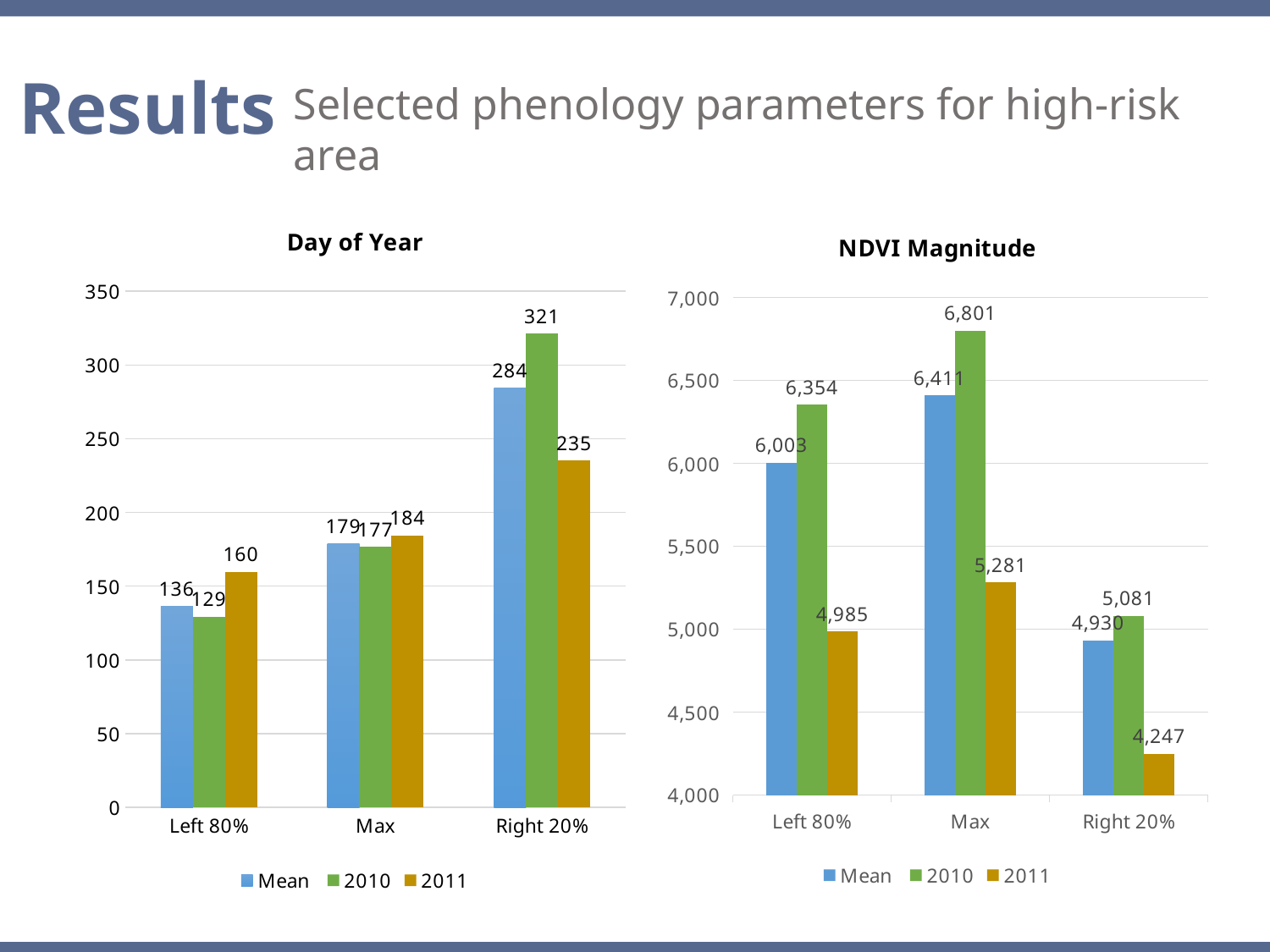
How many categories are shown on the x axis of the Day of Year chart? 3 In the Day of Year chart, what is the difference between the 2010 and 2011 values for Right 20%? 86 In the Day of Year chart, what is the 2010 value for Right 20%? 321 In the NDVI Magnitude chart, what is the difference between the Mean and 2011 values for Left 80%? 1,018 In the Day of Year chart, what is the Mean value for Left 80%? 136 In the NDVI Magnitude chart, which category has the lowest Mean value? Right 20% In the NDVI Magnitude chart, what is the 2011 value for Right 20%? 4,247 In the Day of Year chart, which category has the highest 2011 value? Right 20% How many series does the legend of the NDVI Magnitude chart list? 3 In the NDVI Magnitude chart, which is larger for Max: the Mean value or the 2011 value? Mean What kind of chart is the Day of Year chart? Bar chart In the NDVI Magnitude chart, what is the 2010 value for Max? 6,801